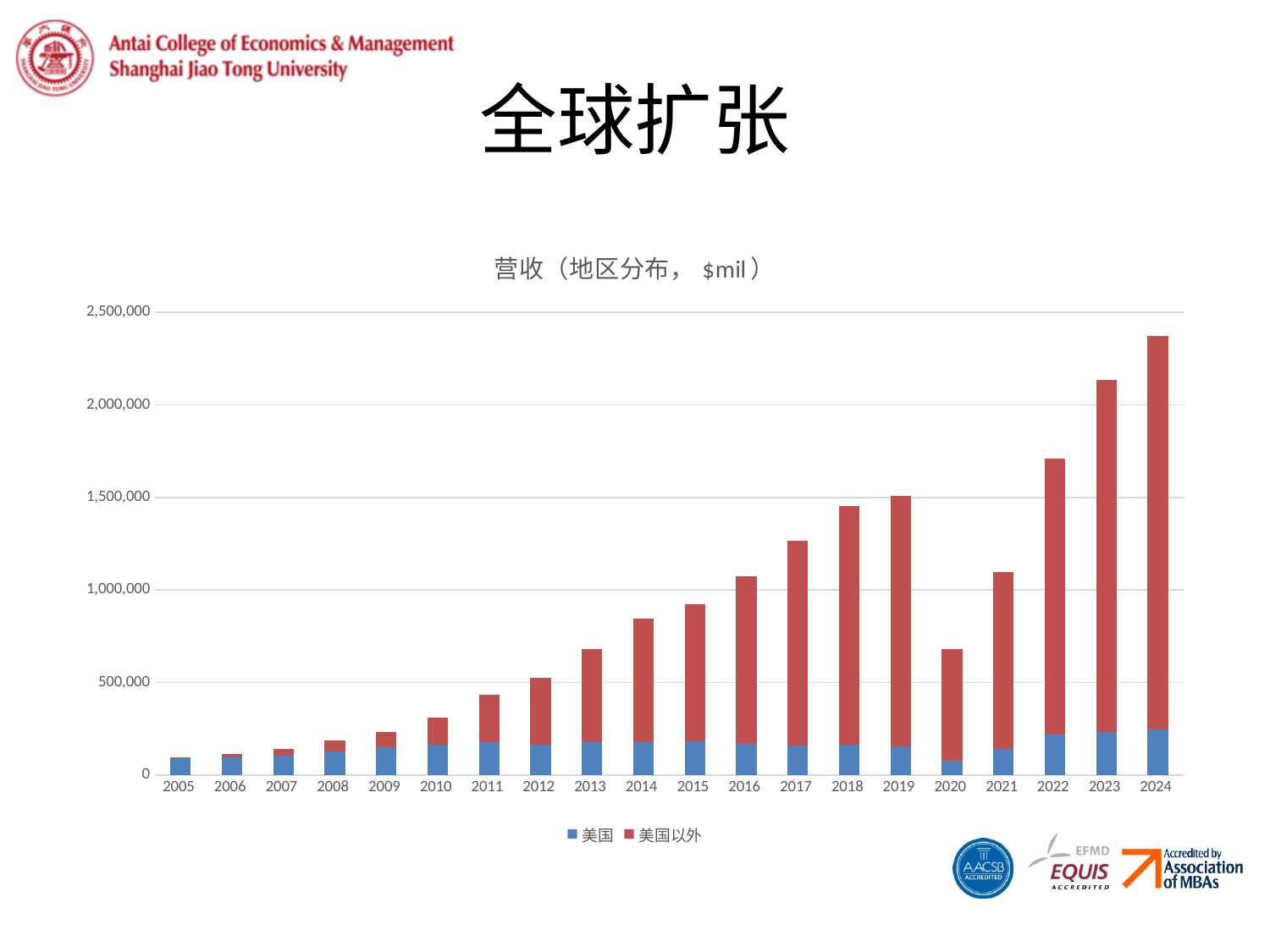
Which year has the larger total bar, 2019 or 2020? 2019 Which year has the tallest bar in the chart? 2024 How many years are shown on the x axis of the chart? 20 Is the total value for 2022 greater or less than 1,500,000? greater What are the two legend entries of the chart? 美国 and 美国以外 Is the total value for 2020 greater or less than 1,000,000? less Is the total value for 2017 greater or less than 1,000,000? greater Which year has the shortest bar in the chart? 2005 Overall, do the total bars rise or fall from 2005 to 2024? rise How many series does the chart's legend list? 2 What kind of chart is shown on the slide? Stacked bar chart